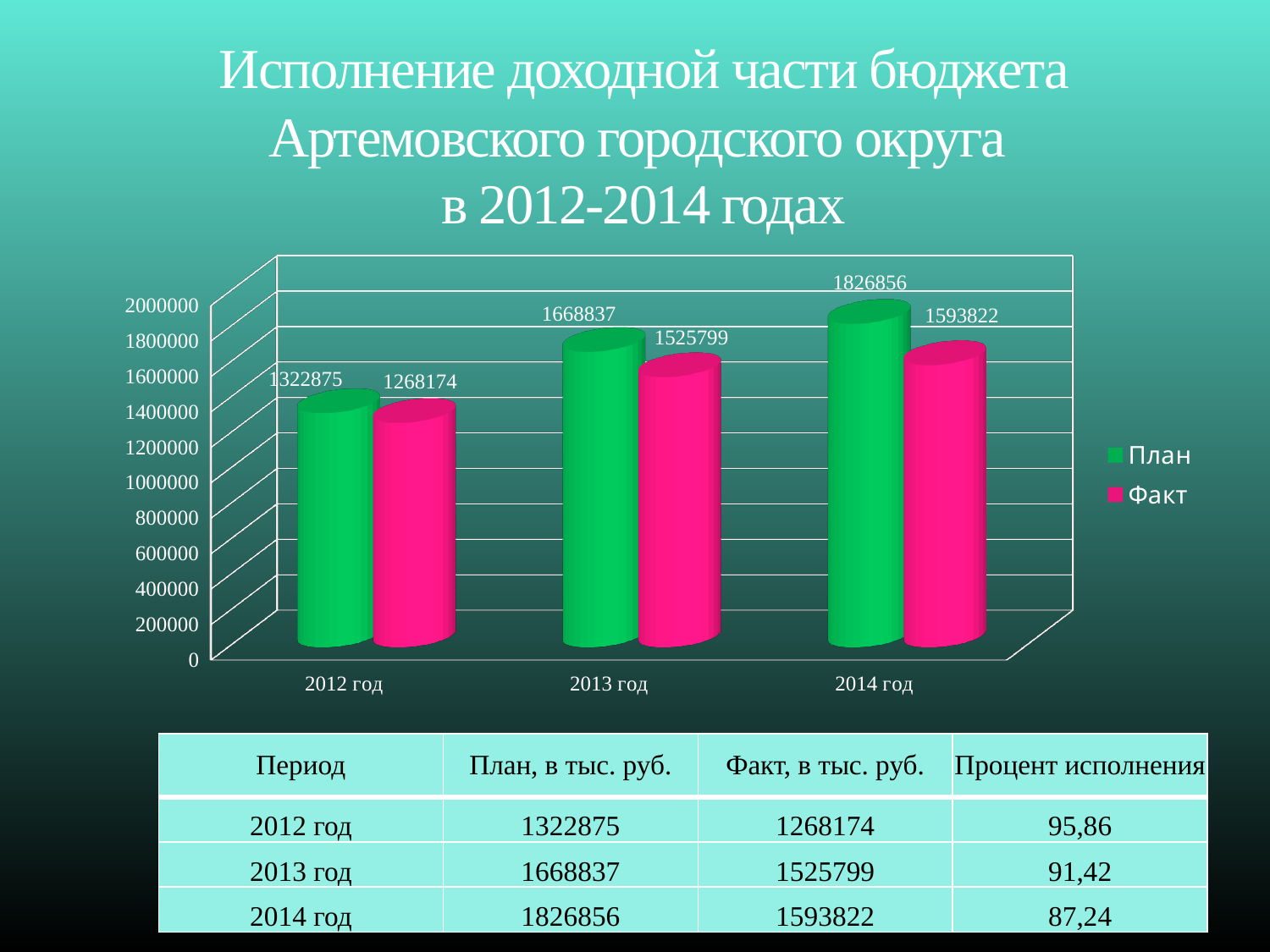
How many series does the chart legend list? 2 What is the value of Факт for 2014 год? 1593822 What is the difference between План and Факт for 2012 год? 54701 What kind of chart is shown on the slide? bar chart How many years are shown on the x axis of the chart? 3 Which is larger for 2013 год, План or Факт? План What is the value of План for 2013 год? 1668837 Which year has the highest План value? 2014 год Is the Факт value for 2013 год greater or less than 1400000? greater What is the difference between План and Факт for 2014 год? 233034 What is the value of Факт for 2012 год? 1268174 Which year has the lowest Факт value? 2012 год